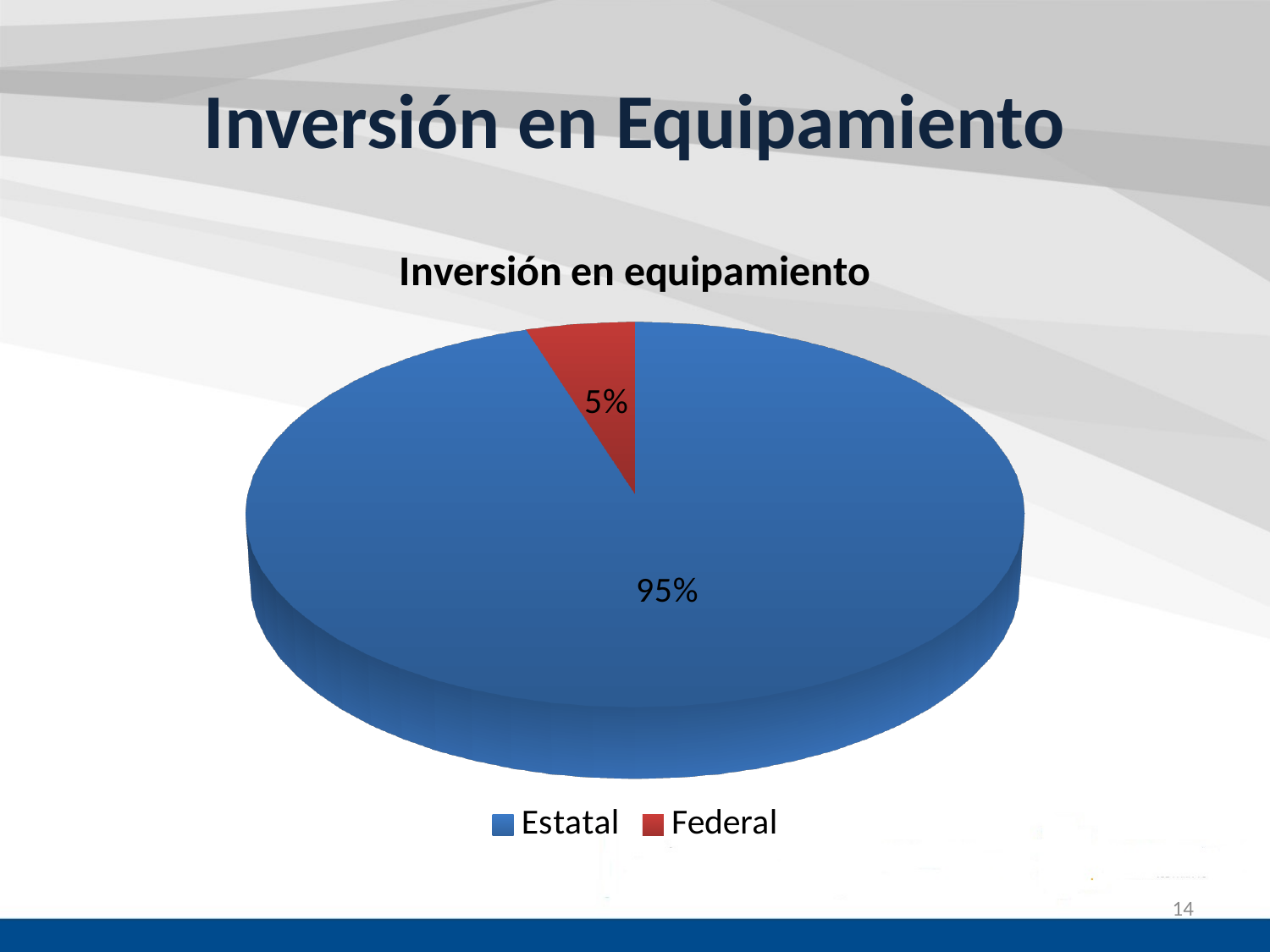
Which is larger, the Estatal slice or the Federal slice? Estatal How many categories are shown in the pie chart? 2 What is the difference in percentage points between the Estatal and Federal slices? 90 Which category has the smallest slice of the pie? Federal What colour is the Federal slice? Red How many entries does the legend list? 2 What share of the pie does Estatal represent? 95% What kind of chart is shown on the slide? Pie chart What share of the pie does Federal represent? 5% What is the title of the chart? Inversión en equipamiento Which category has the largest slice of the pie? Estatal